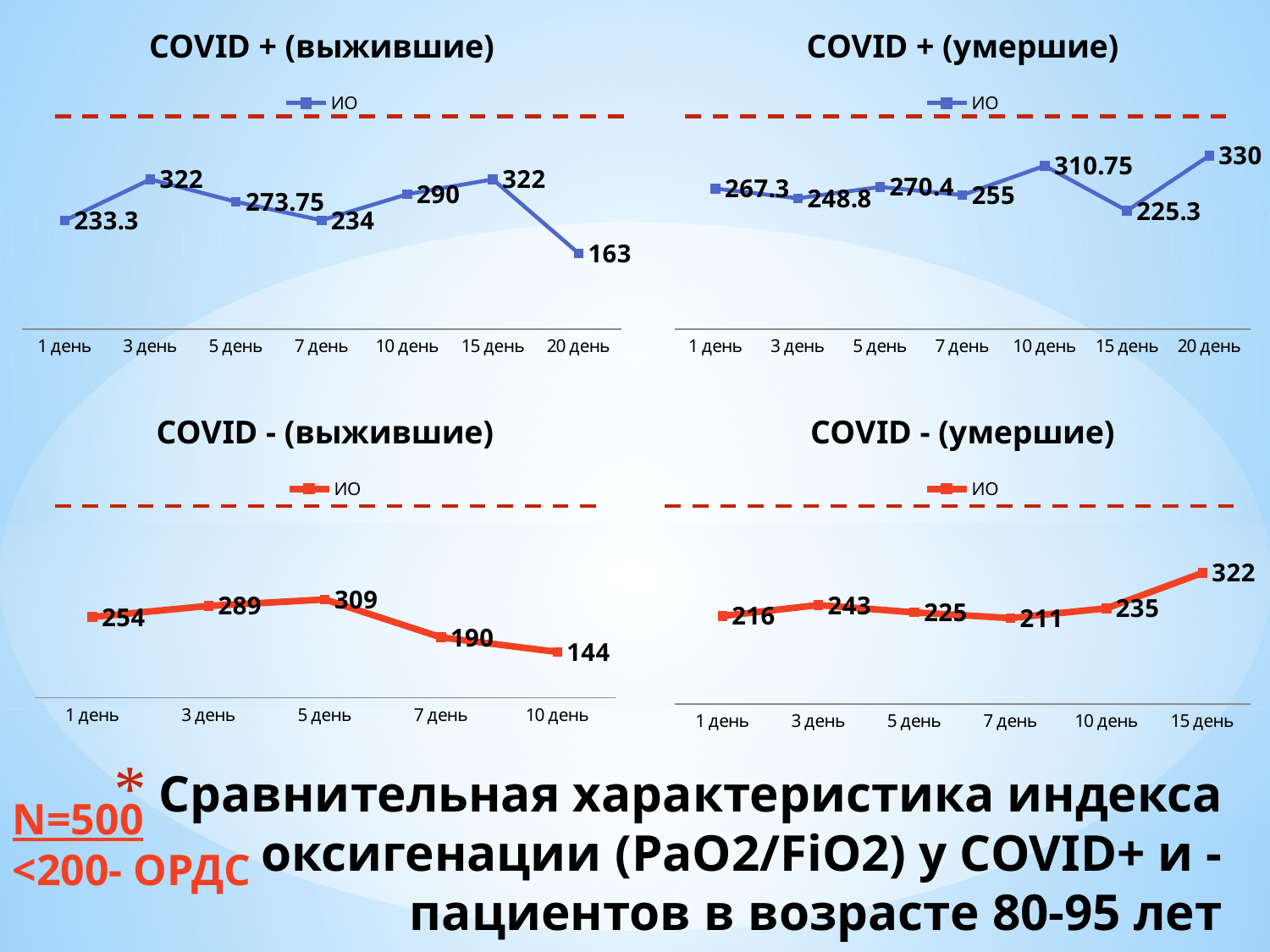
In the 'COVID + (умершие)' chart, which day has the highest value? 20 день In the 'COVID - (выжившие)' chart, do the values rise or fall from 5 день to 10 день? fall In the 'COVID - (выжившие)' chart, how many data points are plotted? 5 In the 'COVID - (умершие)' chart, what is the value for 7 день? 211 In the 'COVID + (выжившие)' chart, which day has the lowest value? 20 день In the 'COVID + (умершие)' chart, what is the difference between the values for 20 день and 15 день? 104.7 In the 'COVID - (умершие)' chart, how many data points are plotted? 6 In the 'COVID + (выжившие)' chart, what is the value for 20 день? 163 In the 'COVID - (выжившие)' chart, what is the value for 5 день? 309 What type of chart is the 'COVID + (выжившие)' chart? line chart In the 'COVID - (умершие)' chart, which is larger, the value for 3 день or the value for 10 день? 3 день In the 'COVID + (умершие)' chart, what is the value for 10 день? 310.75